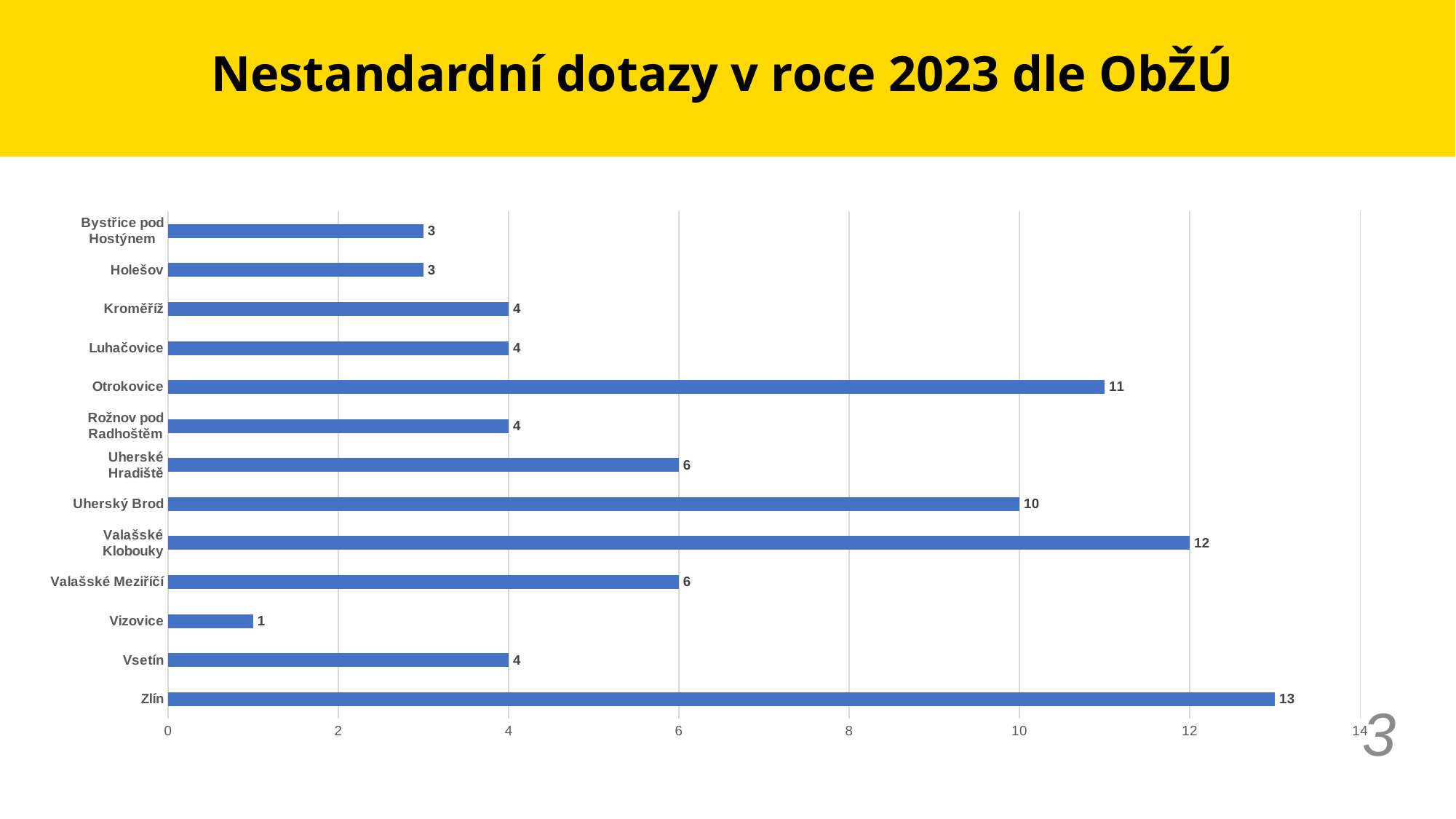
Is the value for Valašské Klobouky greater or less than 10? greater Which category has the lowest value? Vizovice Which category has the highest value? Zlín What is the value for Uherský Brod? 10 What is the value for Otrokovice? 11 What is the difference between the values for Zlín and Valašské Klobouky? 1 Which is larger, the value for Uherský Brod or the value for Valašské Meziříčí? Uherský Brod What is the value for Vizovice? 1 What is the title of the slide? Nestandardní dotazy v roce 2023 dle ObŽÚ What is the difference between the values for Otrokovice and Uherské Hradiště? 5 What kind of chart is shown on the slide? bar chart How many categories are shown in the chart? 13